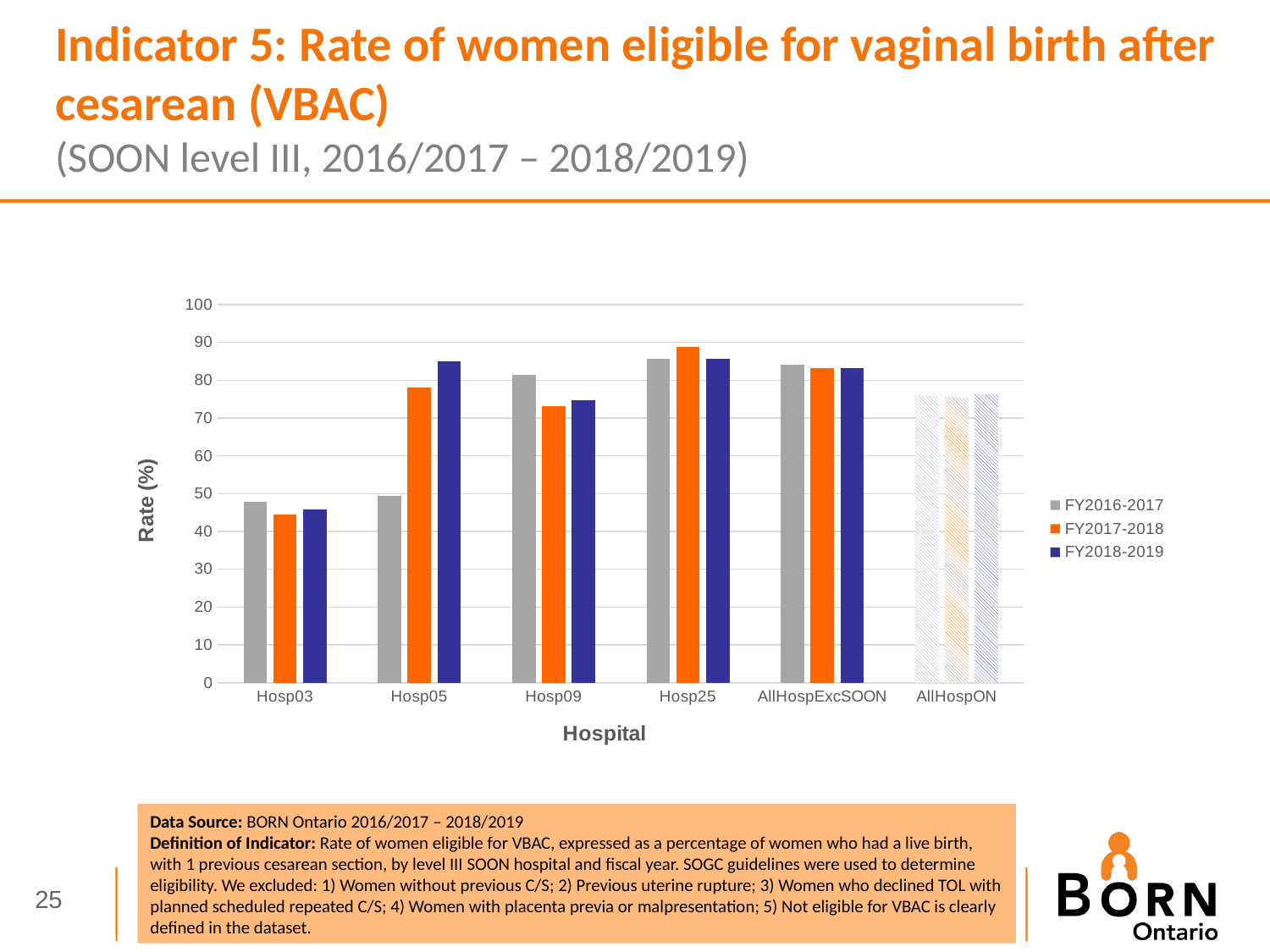
For Hosp05, which is larger: the FY2016-2017 value or the FY2018-2019 value? FY2018-2019 Is the FY2016-2017 value for Hosp03 greater or less than 60? less How many series does the legend list? 3 For Hosp09, which is larger: the FY2016-2017 value or the FY2017-2018 value? FY2016-2017 Is the FY2018-2019 value for Hosp05 greater or less than 80? greater What kind of chart is shown on the slide? bar chart Which hospital category has the lowest FY2017-2018 value? Hosp03 Is the FY2017-2018 value for AllHospON greater or less than 70? greater How many hospital categories are shown on the x axis? 6 What is the title of the y axis? Rate (%) Which hospital category has the highest FY2017-2018 value? Hosp25